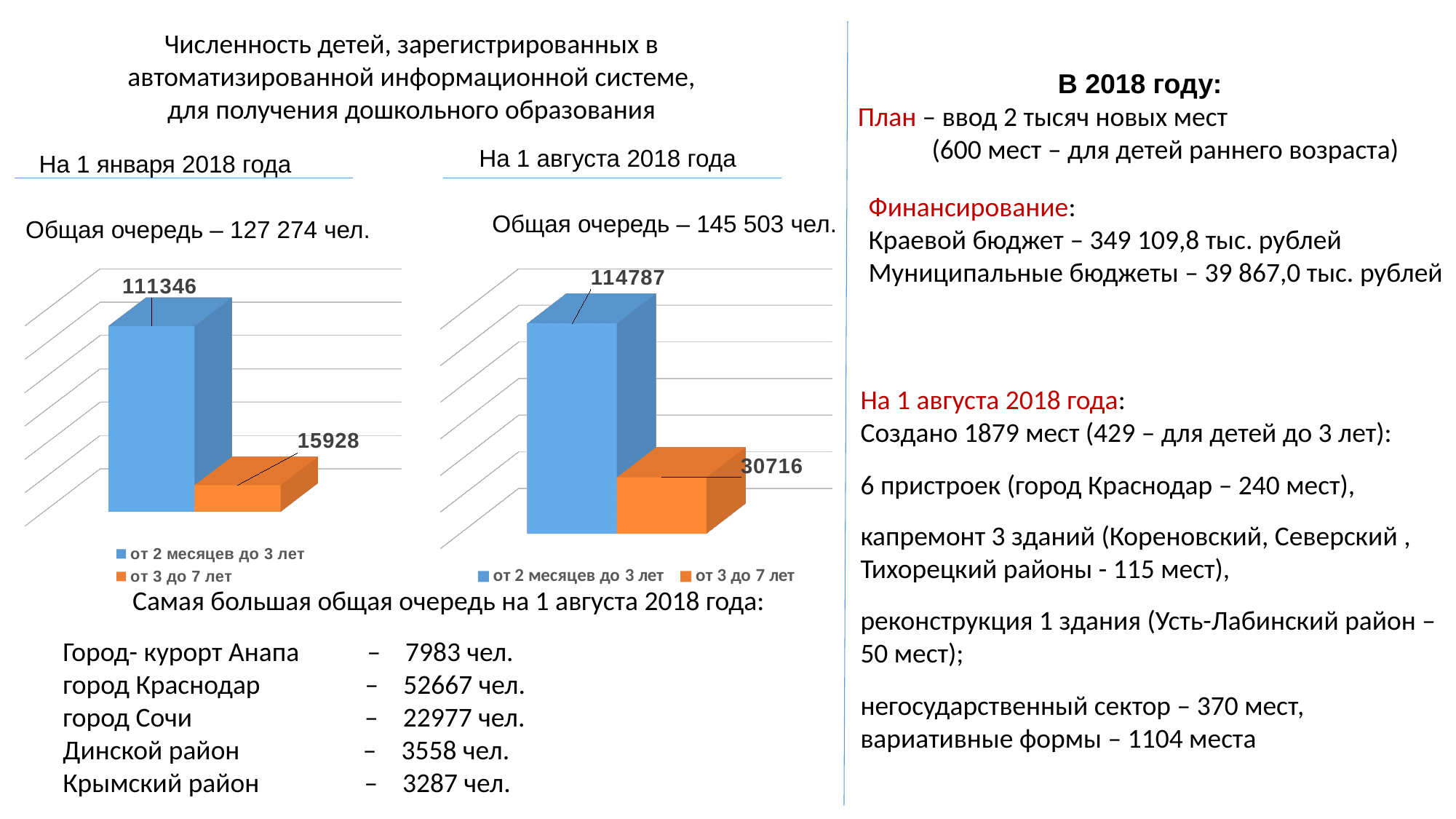
In the chart 'На 1 января 2018 года', what is the difference between the values for 'от 2 месяцев до 3 лет' and 'от 3 до 7 лет'? 95418 In the chart 'На 1 августа 2018 года', what is the value for 'от 2 месяцев до 3 лет'? 114787 How many series does the legend of the chart 'На 1 августа 2018 года' list? 2 In the chart 'На 1 августа 2018 года', which series has the highest value? от 2 месяцев до 3 лет In the chart 'На 1 января 2018 года', what is the value for 'от 3 до 7 лет'? 15928 In the chart 'На 1 января 2018 года', what colour is the bar for 'от 3 до 7 лет'? orange What kind of chart is the chart 'На 1 января 2018 года'? bar chart Is the value for 'от 3 до 7 лет' larger in the chart 'На 1 января 2018 года' or in the chart 'На 1 августа 2018 года'? На 1 августа 2018 года In the chart 'На 1 января 2018 года', which series has the lowest value? от 3 до 7 лет In the chart 'На 1 августа 2018 года', what is the difference between the values for 'от 2 месяцев до 3 лет' and 'от 3 до 7 лет'? 84071 In the chart 'На 1 августа 2018 года', what is the value for 'от 3 до 7 лет'? 30716 In the chart 'На 1 января 2018 года', what is the value for 'от 2 месяцев до 3 лет'? 111346